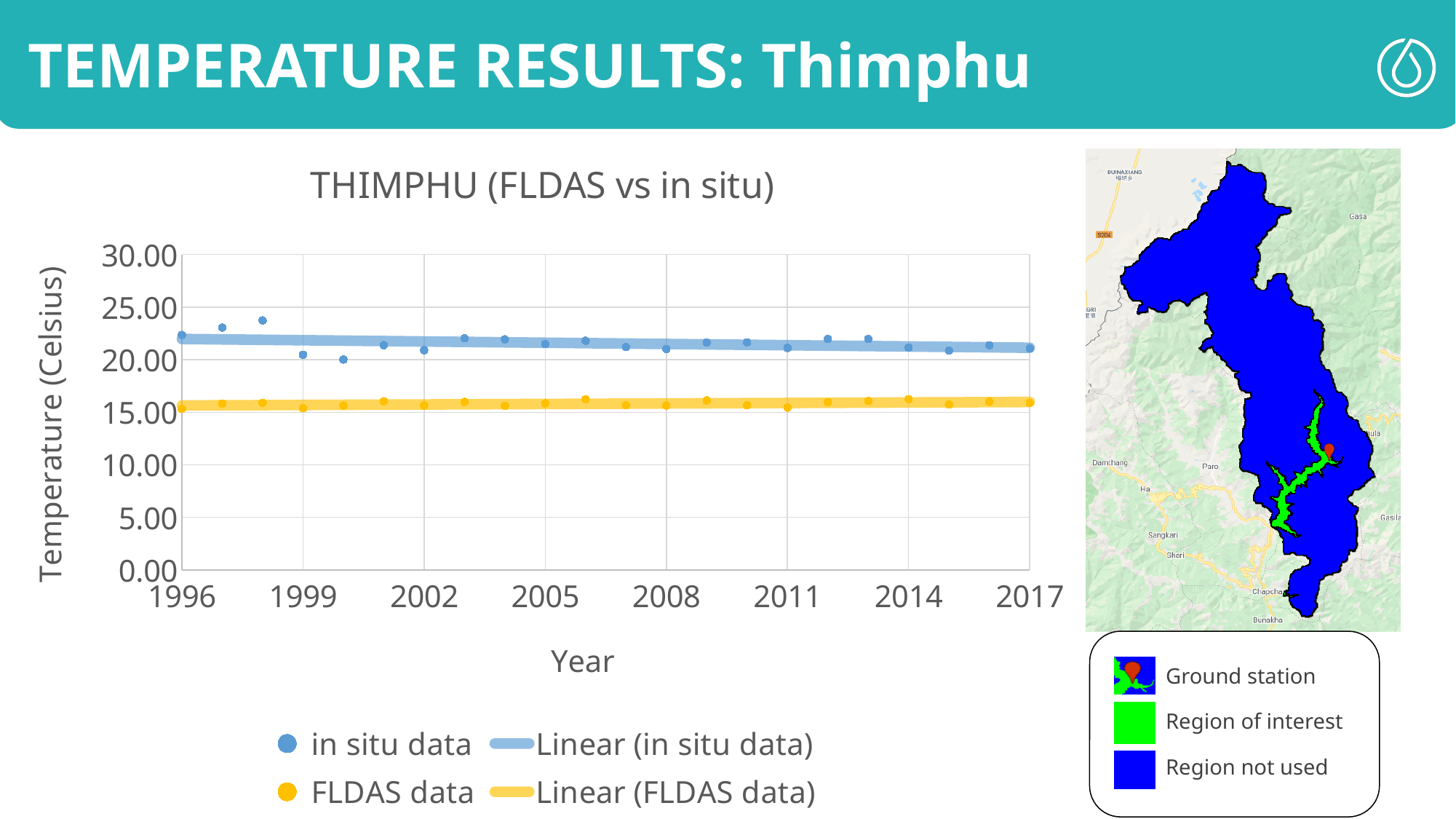
In which year is the in situ data value highest? 1998 In which year is the in situ data value lowest? 2000 Is the FLDAS data value for 2006 greater or less than 20.00? less Is the FLDAS data value for 2006 greater or less than 15.00? greater Is the in situ data value for 1998 greater or less than 20.00? greater What is the label of the vertical axis? Temperature (Celsius) What is the title of the chart? THIMPHU (FLDAS vs in situ) What kind of chart is shown on the slide? scatter chart Does the Linear (in situ data) trend line rise or fall from 1996 to 2017? fall How many entries does the chart legend list? 4 In 2008, which series has the higher value, in situ data or FLDAS data? in situ data